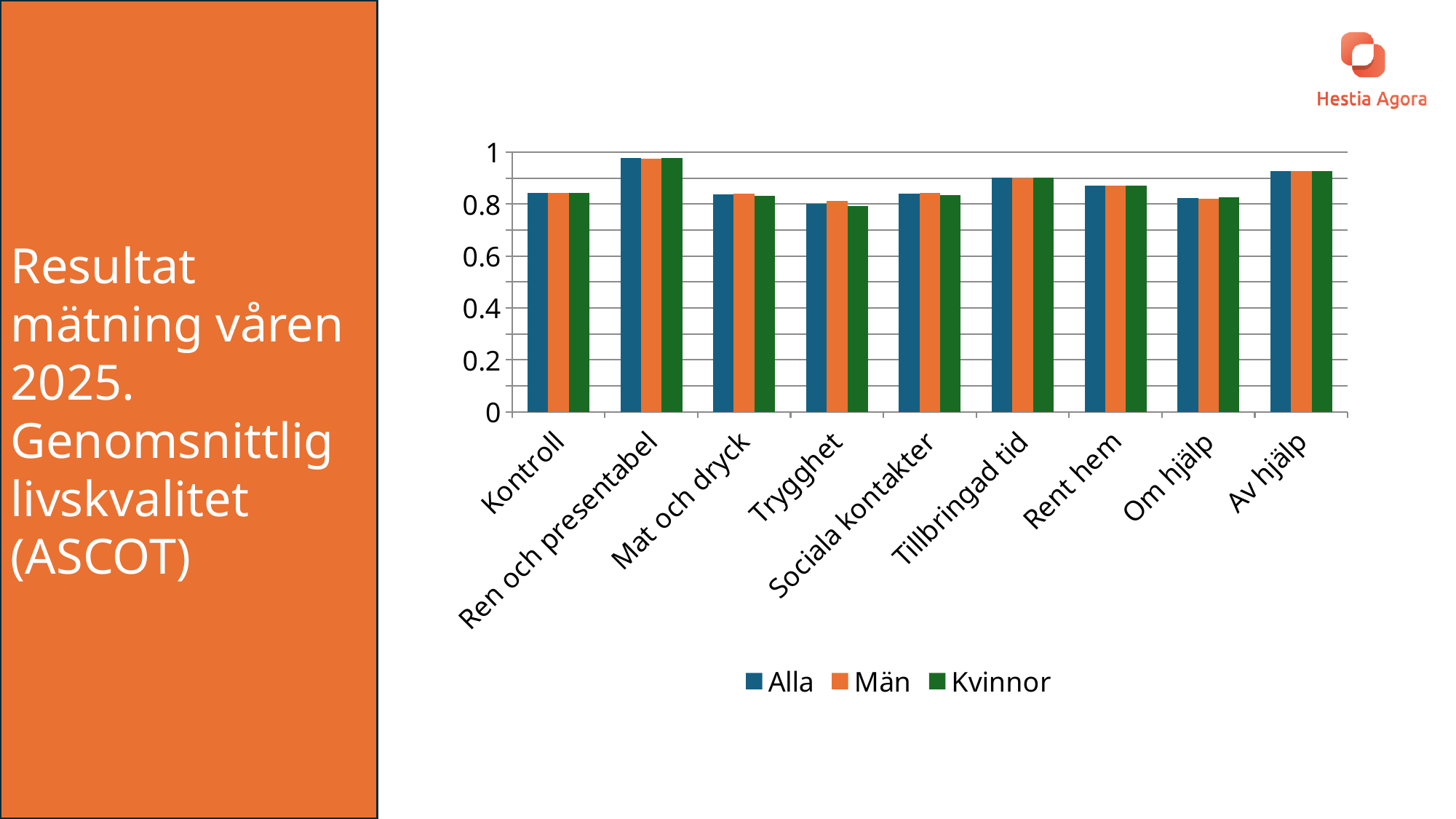
How many categories are shown along the x axis of the chart? 9 For the Alla series, which is larger: Tillbringad tid or Om hjälp? Tillbringad tid Which category has the lowest value for the Kvinnor series? Trygghet Is the Alla value for Trygghet greater or less than 0.9? less For the Män series, which is larger: Av hjälp or Kontroll? Av hjälp Is the Kvinnor value for Av hjälp greater or less than 0.8? greater Which category has the highest value for the Alla series? Ren och presentabel What kind of chart is shown on the slide? bar chart Is the Män value for Kontroll greater or less than 1? less How many series does the chart's legend list? 3 Which colour represents the Män series in the chart's legend? orange